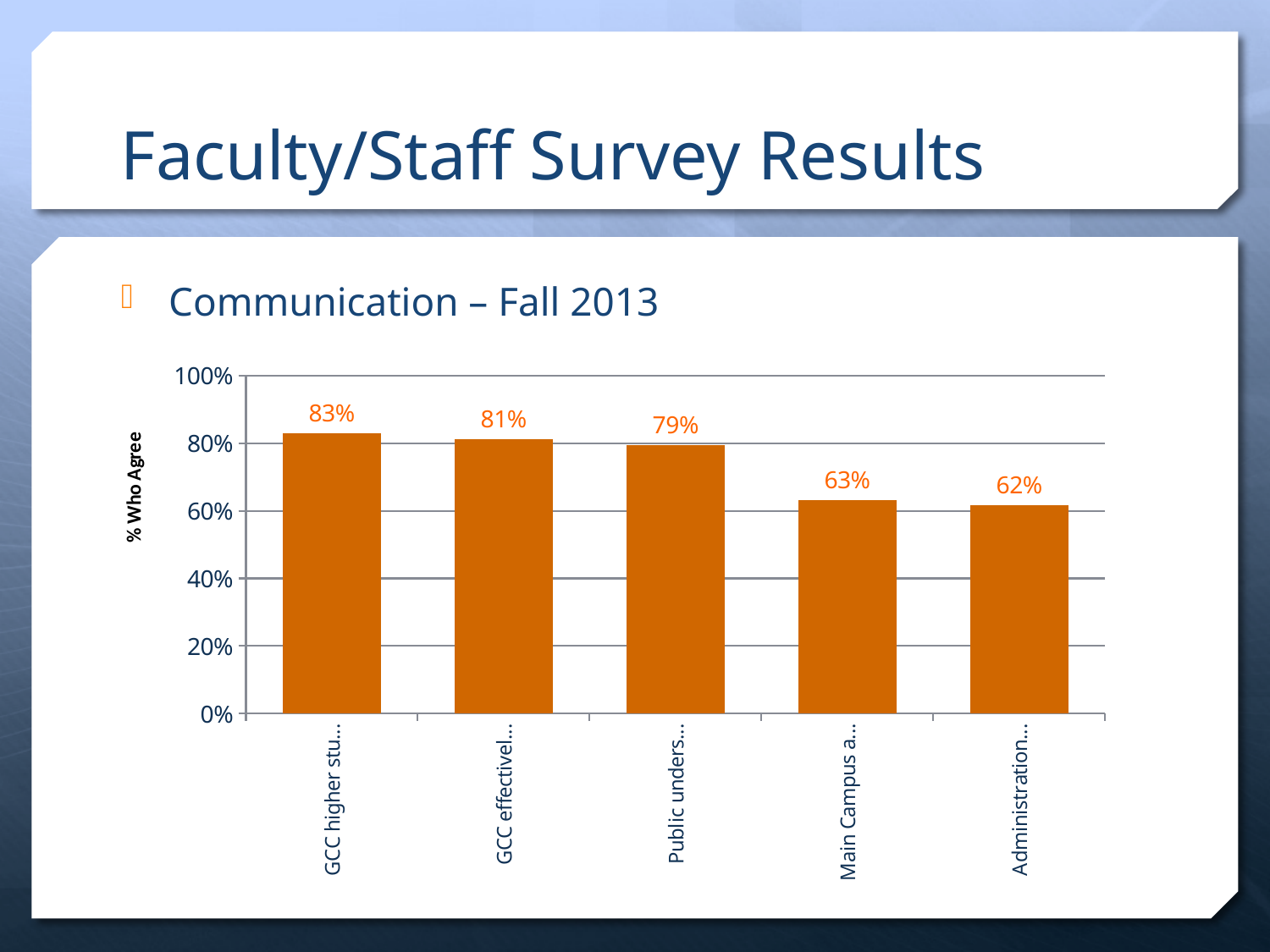
Which bar has the highest value? The first bar, "GCC higher stu..." (83%) What is the label on the vertical axis of the chart? % Who Agree What is the value of the bar labelled "Public unders..."? 79% Which is larger, the value for "GCC effectivel..." or the value for "Main Campus a..."? GCC effectivel... (81%) What is the difference between the highest bar (83%) and the lowest bar (62%)? 21 percentage points How many bars are shown in the chart? 5 Is the value for "Public unders..." greater or less than 60%? greater What is the value of the first bar (labelled "GCC higher stu...")? 83% Which bar has the lowest value? The last bar, "Administration..." (62%) What kind of chart is shown on the slide? Bar chart What is the value of the last bar (labelled "Administration...")? 62% What is the value of the bar labelled "Main Campus a..."? 63%